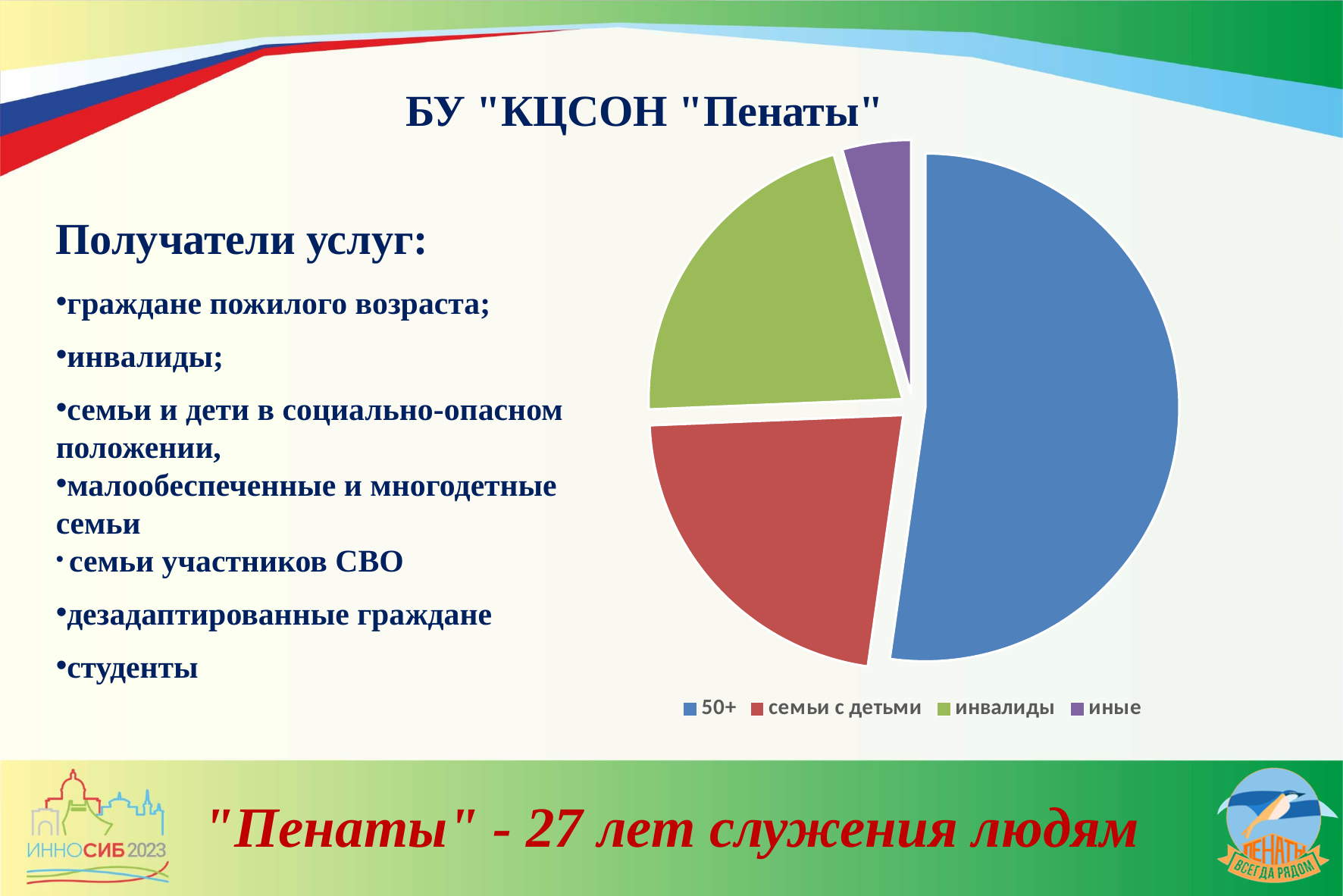
How many slices does the pie chart have? 4 Which category has the smallest slice of the pie? иные Which category has the largest slice of the pie? 50+ Which slice is larger: инвалиды or иные? инвалиды Which colour represents the category 50+ in the pie chart? blue What kind of chart is shown on the slide? pie chart Which slice is larger: 50+ or иные? 50+ Which slice is larger: 50+ or семьи с детьми? 50+ How many entries does the chart legend list? 4